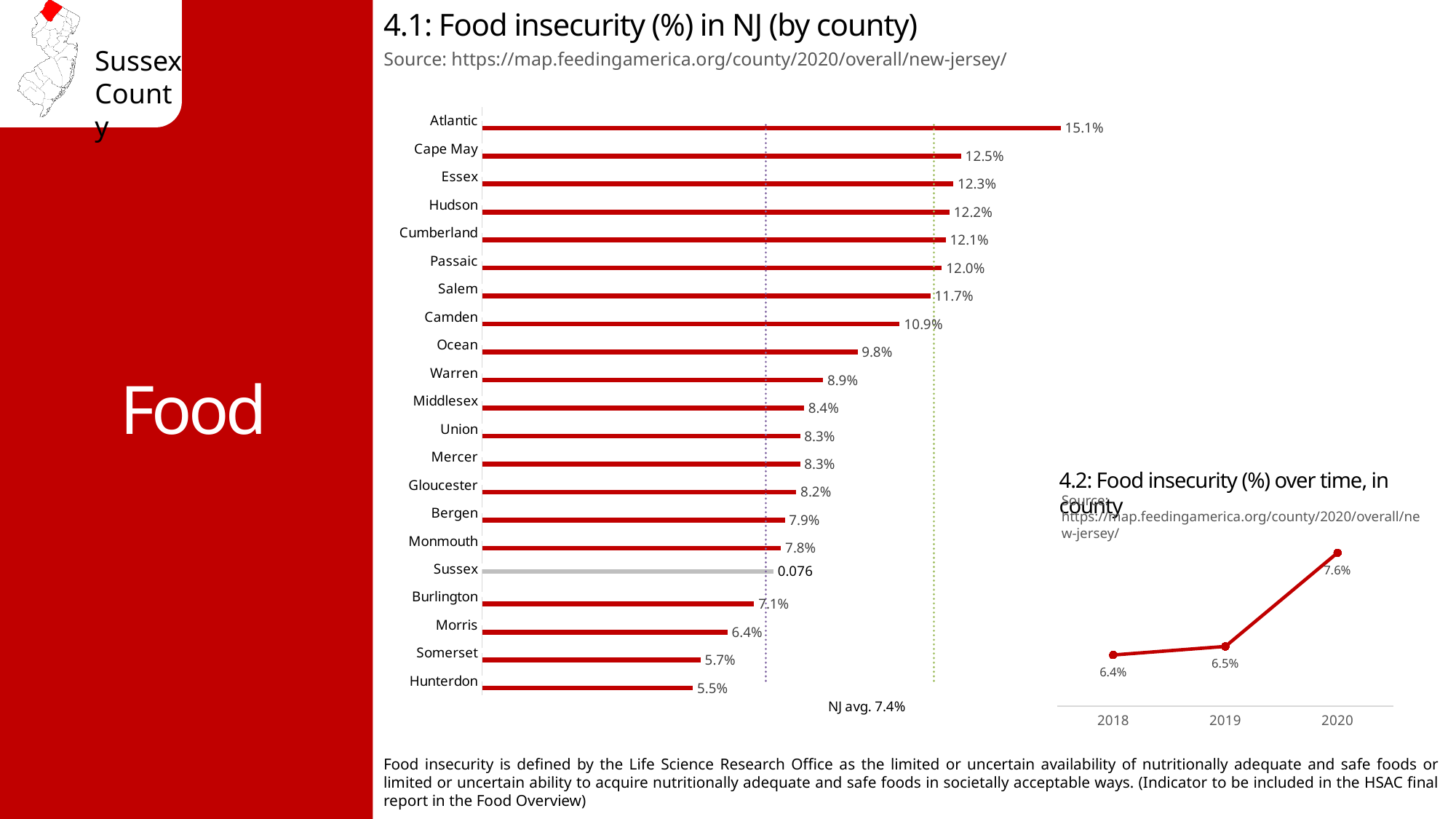
In chart 4.1 (Food insecurity (%) in NJ by county), what is the value for Atlantic? 15.1% In chart 4.1, what is the data label shown for Sussex? 0.076 In chart 4.2, do the values rise or fall from 2018 to 2020? Rise In chart 4.1, what is the value for Camden? 10.9% In chart 4.1, what is the difference between the values for Atlantic and Cape May? 2.6% In chart 4.1, which county has the highest food insecurity percentage? Atlantic In chart 4.2 (Food insecurity (%) over time, in county), what is the value for 2020? 7.6% What kind of chart is chart 4.1? Bar chart In chart 4.1, which county has a higher value, Ocean or Warren? Ocean In chart 4.1, how many counties are plotted? 21 In chart 4.1, which county has the lowest food insecurity percentage? Hunterdon In chart 4.1, what NJ average value is noted on the chart? 7.4%